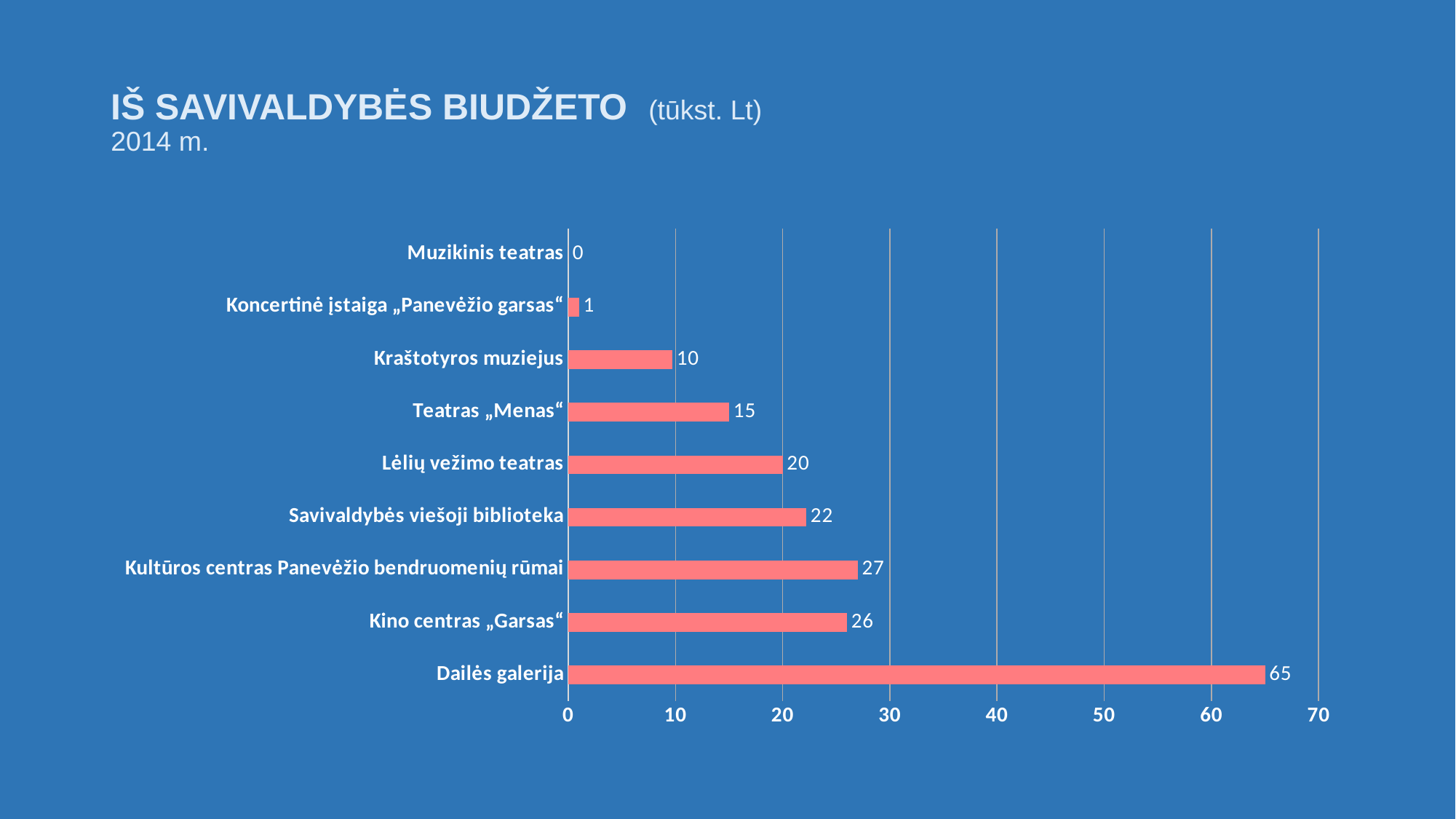
Which category has the lowest value? Muzikinis teatras What is the value for Koncertinė įstaiga „Panevėžio garsas“? 1 Is the value for Kultūros centras Panevėžio bendruomenių rūmai greater or less than 20? greater Which category has the highest value? Dailės galerija Which is larger, the value for Lėlių vežimo teatras or the value for Teatras „Menas“? Lėlių vežimo teatras How many categories are shown in the chart? 9 What is the value for Savivaldybės viešoji biblioteka? 22 What is the title of the chart? IŠ SAVIVALDYBĖS BIUDŽETO (tūkst. Lt) 2014 m. What is the value for Dailės galerija? 65 What kind of chart is shown on the slide? bar chart What is the difference between the values for Dailės galerija and Kino centras „Garsas“? 39 What is the value for Kraštotyros muziejus? 10